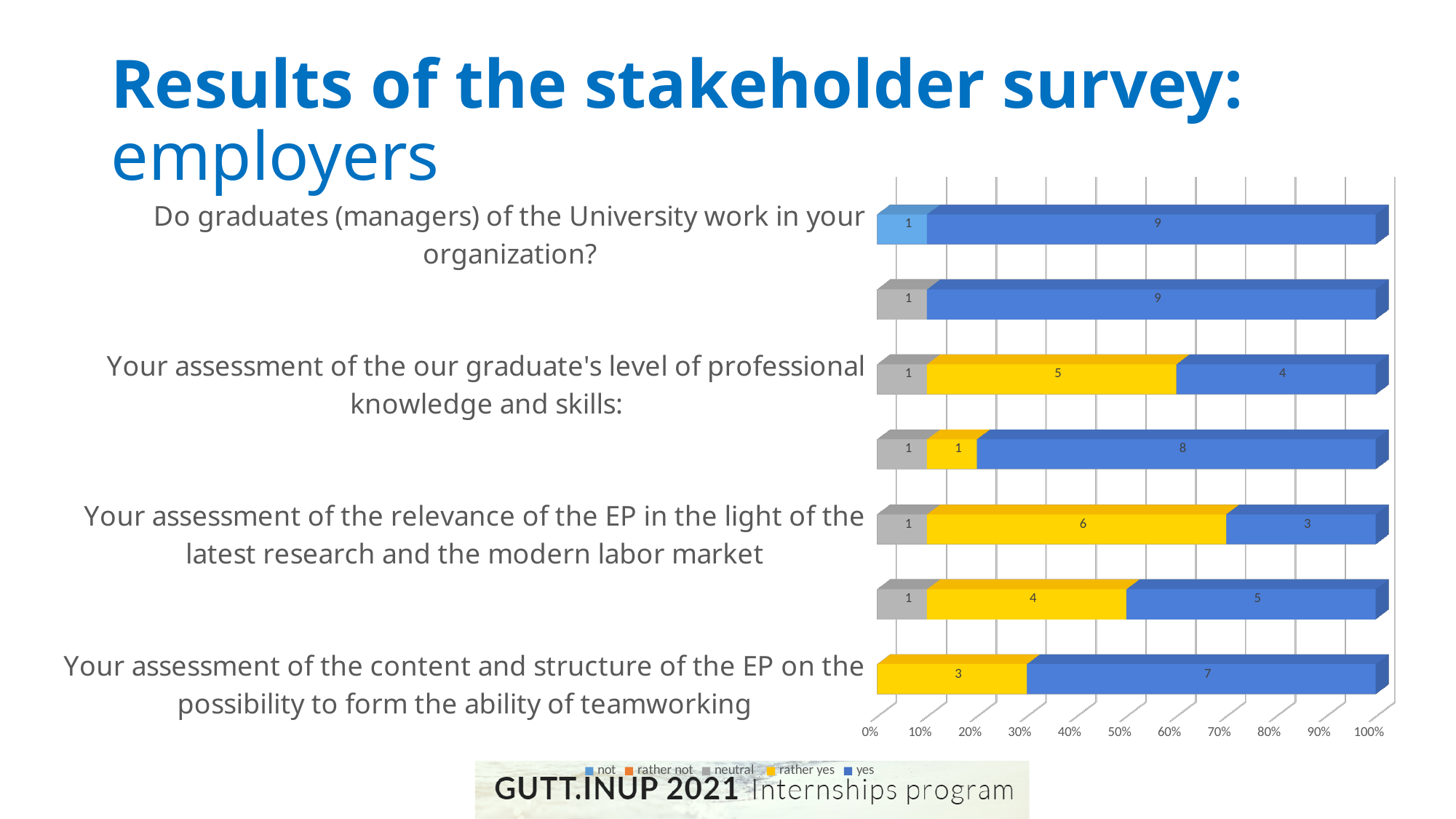
What colour represents the 'rather yes' series in the legend? yellow What is the 'rather yes' value for 'Your assessment of the content and structure of the EP on the possibility to form the ability of teamworking'? 3 For 'Your assessment of the content and structure of the EP on the possibility to form the ability of teamworking', what is the difference between the 'yes' and 'rather yes' values? 4 What is the 'not' value for 'Do graduates (managers) of the University work in your organization?' 1 For 'Your assessment of the relevance of the EP in the light of the latest research and the modern labor market', which is larger: 'rather yes' or 'yes'? rather yes What kind of chart is shown on the slide? bar chart How many bars are plotted in the chart? 7 What is the total of the stacked bar for 'Your assessment of the our graduate's level of professional knowledge and skills:'? 10 What is the 'rather yes' value for 'Your assessment of the our graduate's level of professional knowledge and skills:'? 5 What is the 'yes' value for 'Do graduates (managers) of the University work in your organization?' 9 What is the 'yes' value for 'Your assessment of the relevance of the EP in the light of the latest research and the modern labor market'? 3 How many series does the legend list? 5